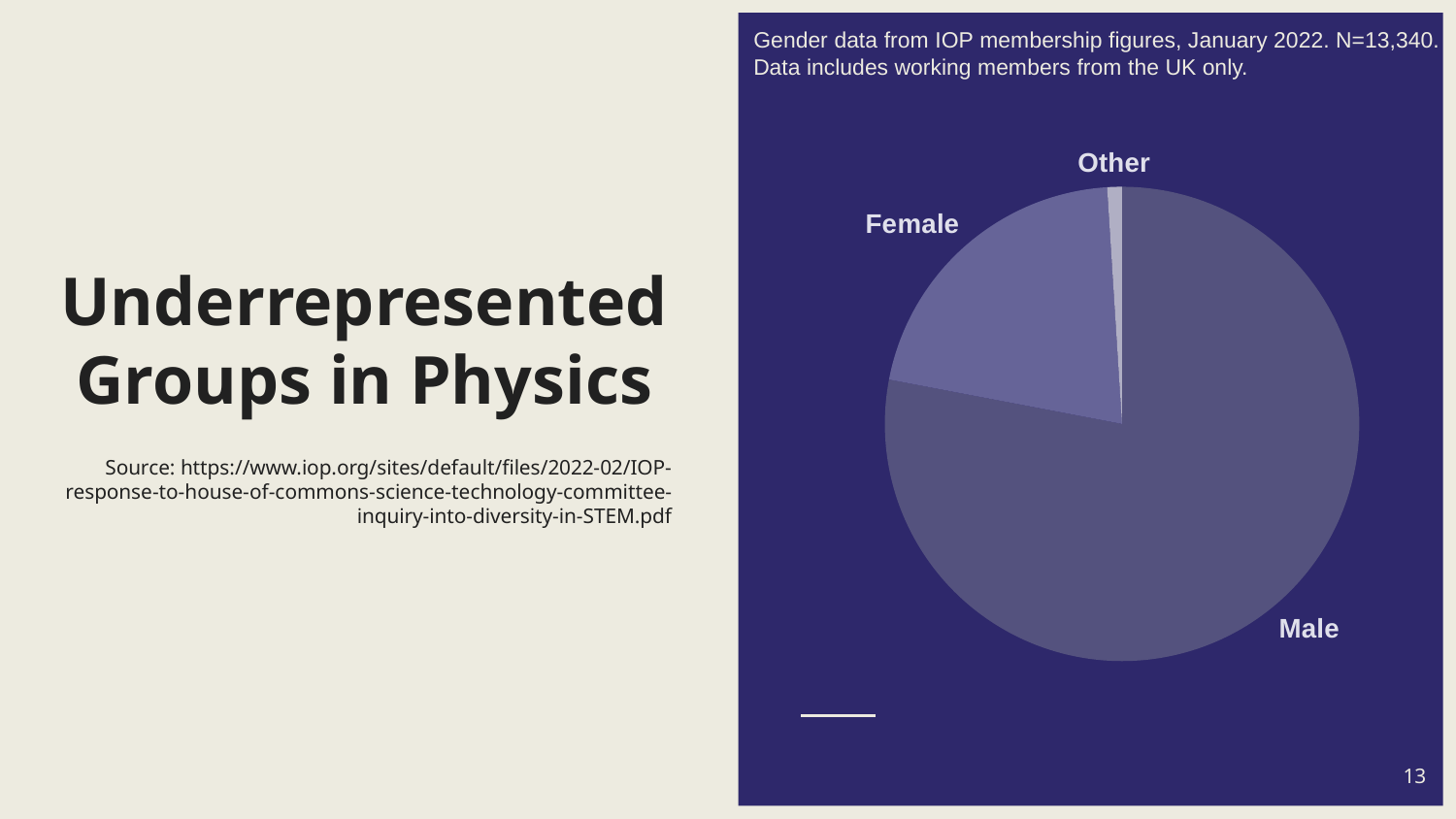
What kind of chart is shown on the slide? pie chart What is the sample size (N) stated in the caption above the pie chart? 13,340 How many slices does the pie chart have? 3 What are the three categories shown in the pie chart? Male, Female, Other Which slice is larger, Female or Other? Female Which category has the largest slice of the pie chart? Male Which slice is larger, Male or Female? Male Which category has the smallest slice of the pie chart? Other